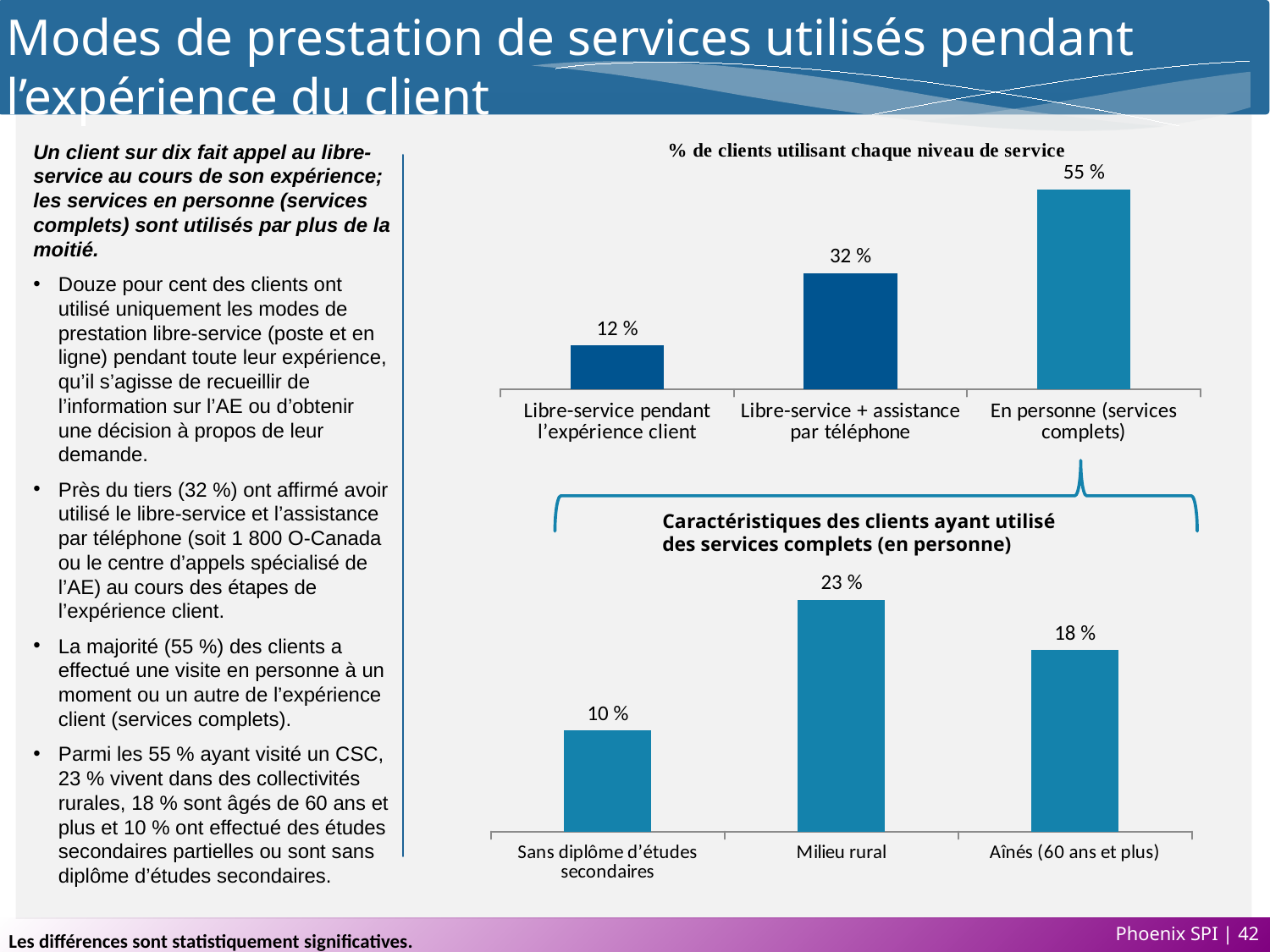
In the top chart '% de clients utilisant chaque niveau de service', how many categories are shown? 3 In the top chart '% de clients utilisant chaque niveau de service', which category has the highest value? En personne (services complets) In the top chart '% de clients utilisant chaque niveau de service', what is the difference between 'En personne (services complets)' and 'Libre-service + assistance par téléphone'? 23 % In the top chart '% de clients utilisant chaque niveau de service', which category has the lowest value? Libre-service pendant l'expérience client What kind of chart is the bottom chart 'Caractéristiques des clients ayant utilisé des services complets (en personne)'? bar chart In the bottom chart 'Caractéristiques des clients ayant utilisé des services complets (en personne)', what is the value for 'Aînés (60 ans et plus)'? 18 % In the top chart '% de clients utilisant chaque niveau de service', what is the value for 'Libre-service pendant l'expérience client'? 12 % In the bottom chart 'Caractéristiques des clients ayant utilisé des services complets (en personne)', what is the value for 'Milieu rural'? 23 % In the bottom chart 'Caractéristiques des clients ayant utilisé des services complets (en personne)', which is larger: 'Milieu rural' or 'Aînés (60 ans et plus)'? Milieu rural In the bottom chart 'Caractéristiques des clients ayant utilisé des services complets (en personne)', which category has the lowest value? Sans diplôme d'études secondaires In the top chart '% de clients utilisant chaque niveau de service', what is the value for 'Libre-service + assistance par téléphone'? 32 % In the top chart '% de clients utilisant chaque niveau de service', do the values rise or fall from left to right? rise